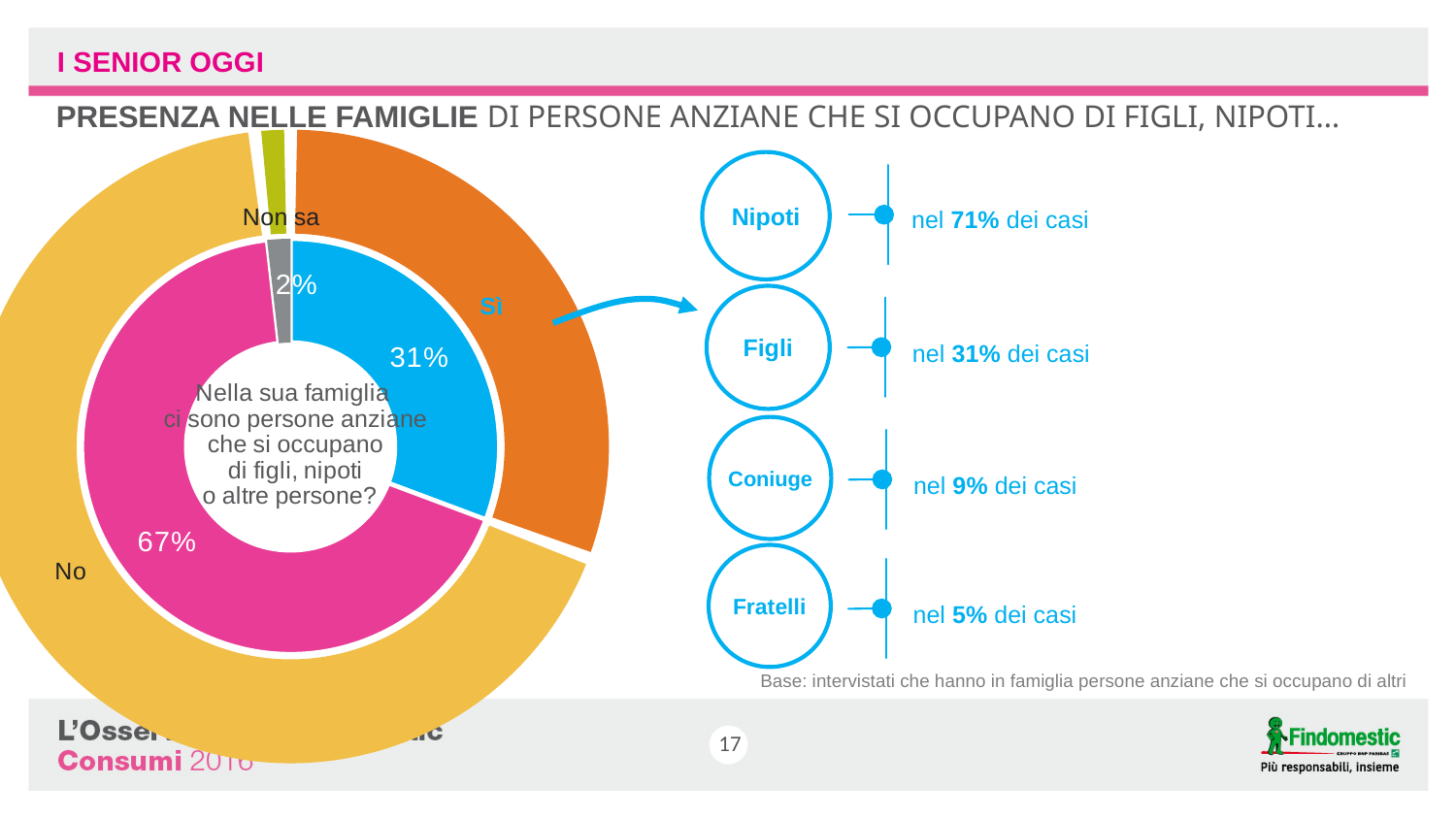
What percentage of respondents answered "No" in the doughnut chart? 67% What percentage of respondents answered "Sì" in the doughnut chart? 31% Which category has the smallest share in the doughnut chart? Non sa What kind of chart is shown on the slide? Doughnut chart What is the difference between the "No" share and the "Sì" share in the doughnut chart? 36 percentage points How many categories are shown in the doughnut chart? 3 What percentage of respondents answered "Non sa" in the doughnut chart? 2% What question is written in the centre of the doughnut chart? Nella sua famiglia ci sono persone anziane che si occupano di figli, nipoti o altre persone? What is the combined share of "Sì" and "No" in the doughnut chart? 98% Which is larger in the doughnut chart, the share for "Sì" or the share for "Non sa"? Sì What colour is the "No" segment of the doughnut chart? Pink (magenta) Which category has the largest share in the doughnut chart? No